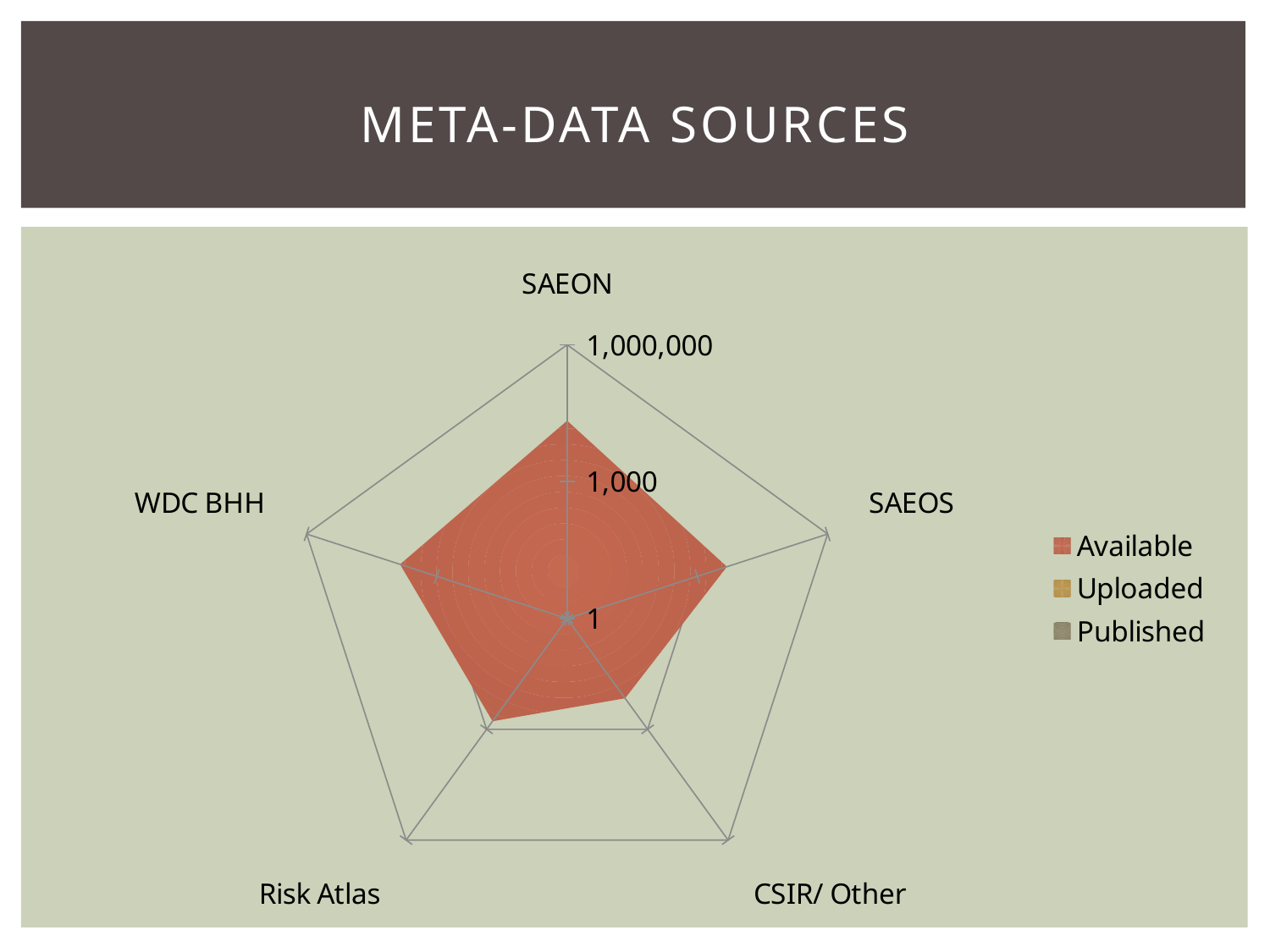
Is the Available value for SAEON greater or less than 1,000,000? less Is the Available value for SAEOS greater or less than 1,000? greater How many categories (axes) does the radar chart have? 5 Is the Available value for CSIR/ Other greater or less than 1,000? less Which has the larger Available value, SAEON or CSIR/ Other? SAEON How many series does the legend list? 3 Which category has the highest Available value? SAEON Which category has the lowest Available value? CSIR/ Other What kind of chart is shown on the slide? Radar chart What is the title of the slide containing the chart? META-DATA SOURCES What are the three series named in the legend? Available, Uploaded, Published